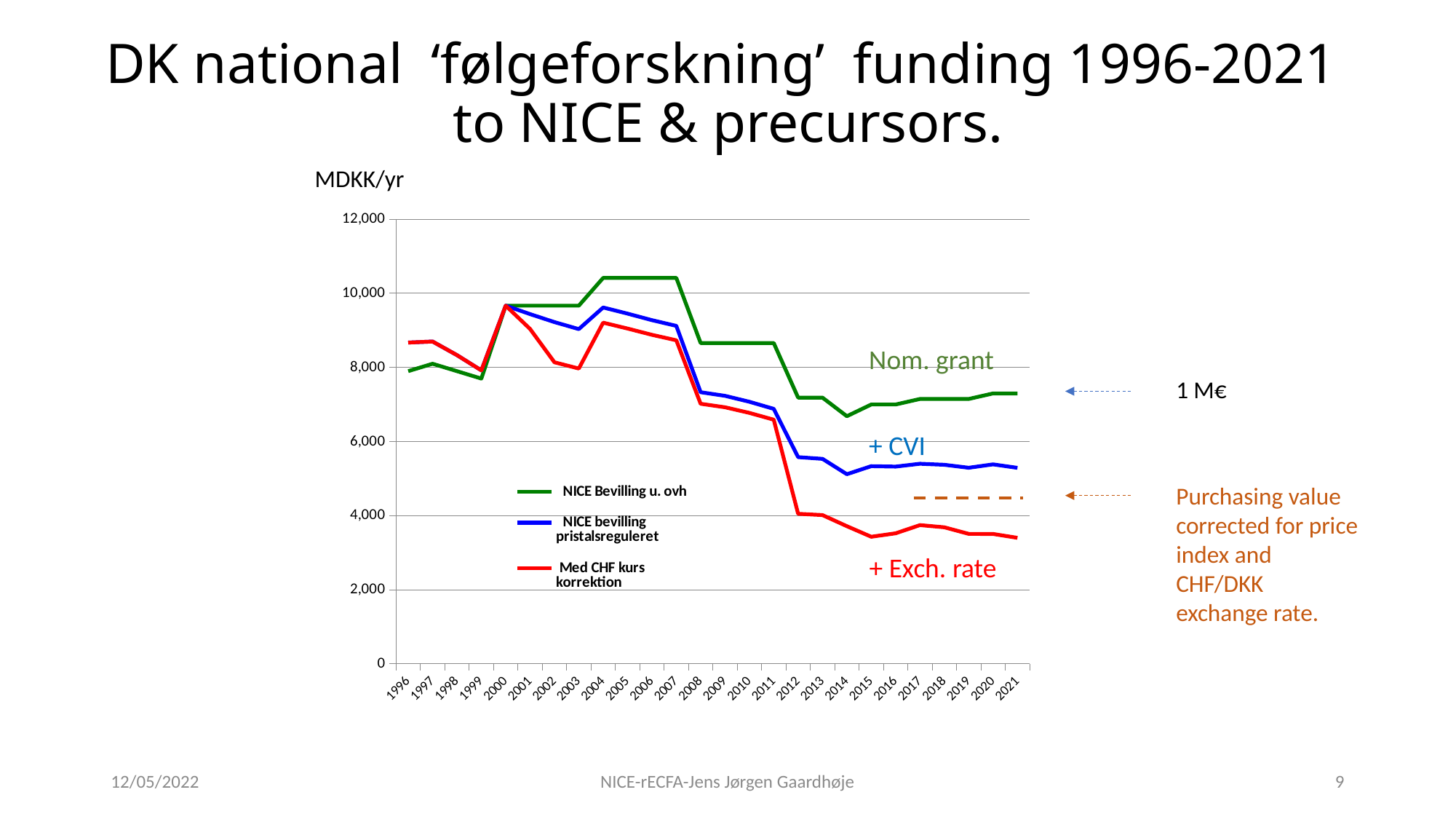
What kind of chart is shown on the slide? line chart In which year does the 'Med CHF kurs korrektion' series reach its highest value? 2000 In 1996, which series has the larger value: 'NICE Bevilling u. ovh' or 'Med CHF kurs korrektion'? Med CHF kurs korrektion Is the value of the 'Med CHF kurs korrektion' series in 2015 greater or less than 4,000? less In which year does the 'NICE Bevilling u. ovh' series reach its lowest value? 2014 How many series does the chart's legend list? 3 Is the value of the 'NICE bevilling pristalsreguleret' series in 2014 greater or less than 6,000? less What unit label is shown above the y axis of the chart? MDKK/yr In 2021, which series has the larger value: 'NICE Bevilling u. ovh' or 'Med CHF kurs korrektion'? NICE Bevilling u. ovh Does the 'Med CHF kurs korrektion' series rise or fall from 2011 to 2012? fall How many years are plotted along the x axis of the chart? 26 Is the value of the 'NICE Bevilling u. ovh' series in 2004 greater or less than 10,000? greater